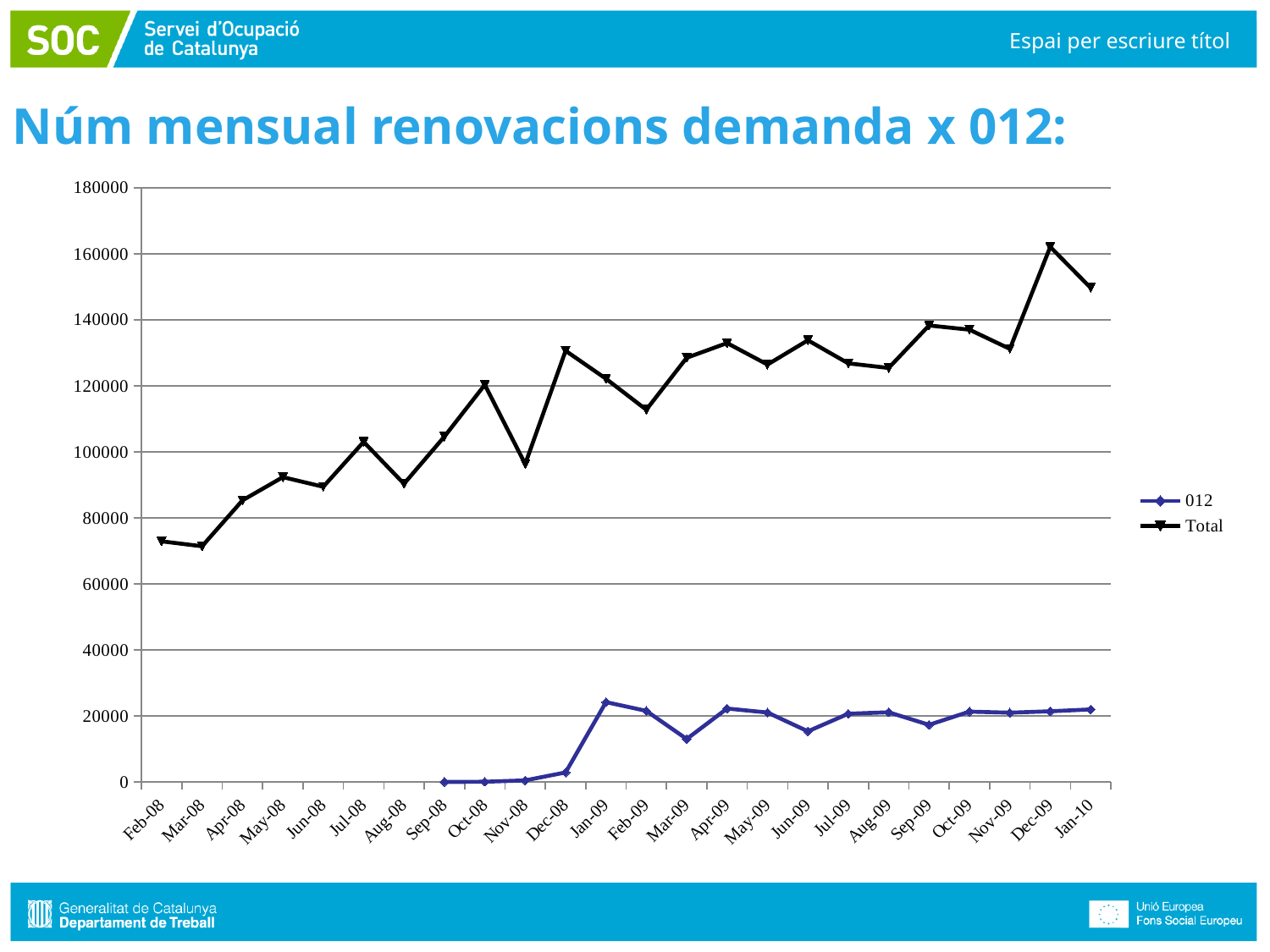
Is the 012 value for Mar-09 greater or less than 20000? less Is the Total value for Nov-08 greater or less than 100000? less What kind of chart is shown on the slide? line chart Is the Total value for Feb-08 greater or less than 80000? less How many series does the legend list? 2 Which is larger for the Total series, the value for Nov-08 or the value for Dec-08? Dec-08 How many months are plotted along the x axis? 24 Overall, does the Total series rise or fall from Feb-08 to Jan-10? rise What are the two series names listed in the legend? 012 and Total In which month does the Total series reach its highest value? Dec-09